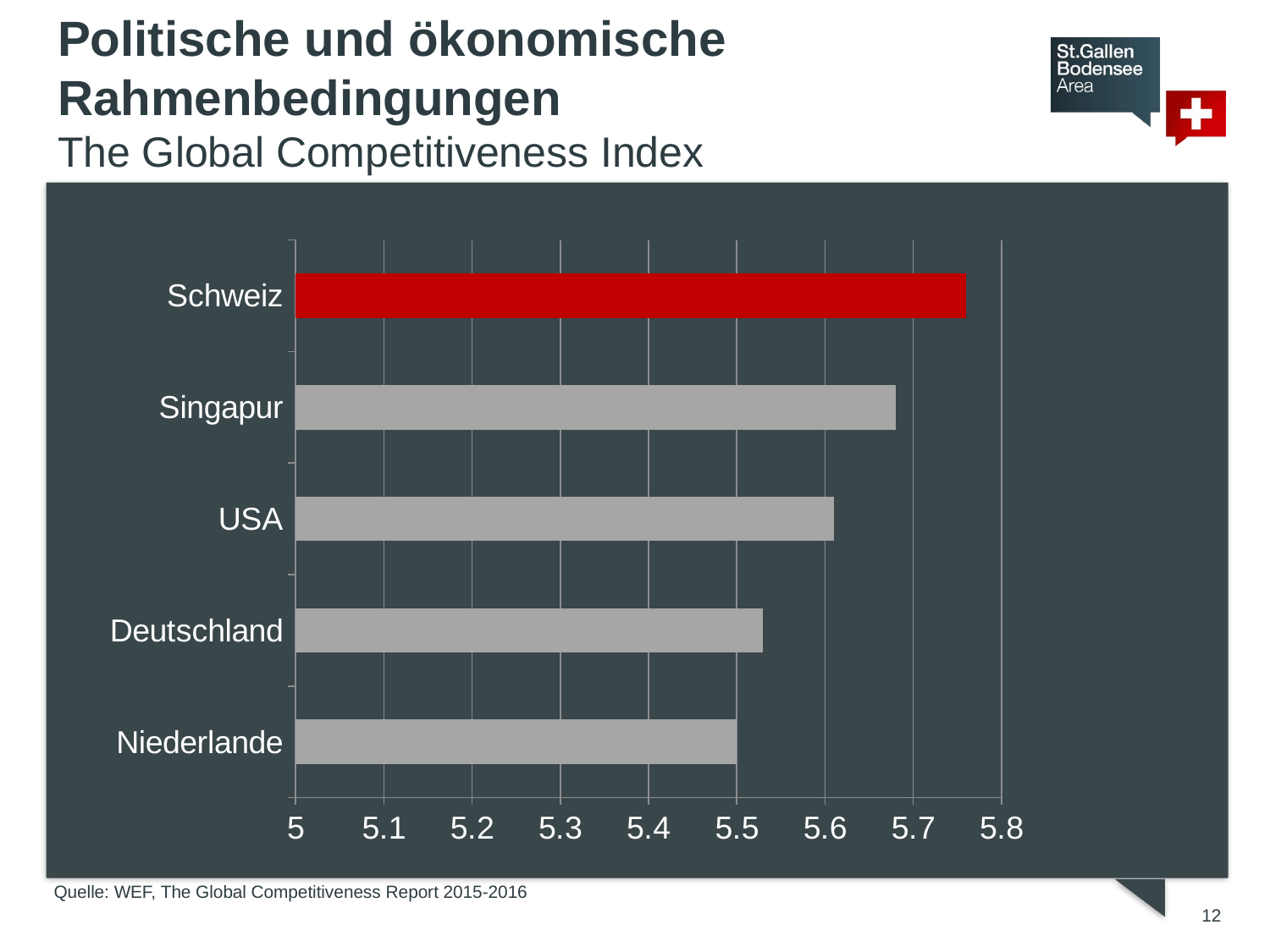
Is the value for USA greater or less than 5.7? less Which has a larger value, Singapur or USA? Singapur Which has a larger value, Deutschland or Niederlande? Deutschland Is the value for Deutschland greater or less than 5.6? less Is the value for Schweiz greater or less than 5.7? greater Which country has the lowest value in the chart? Niederlande Which country has the highest value in the chart? Schweiz What is the subtitle of the chart on the slide? The Global Competitiveness Index Which country's bar is shown in red? Schweiz How many countries are shown in the chart? 5 What kind of chart is shown on the slide? bar chart